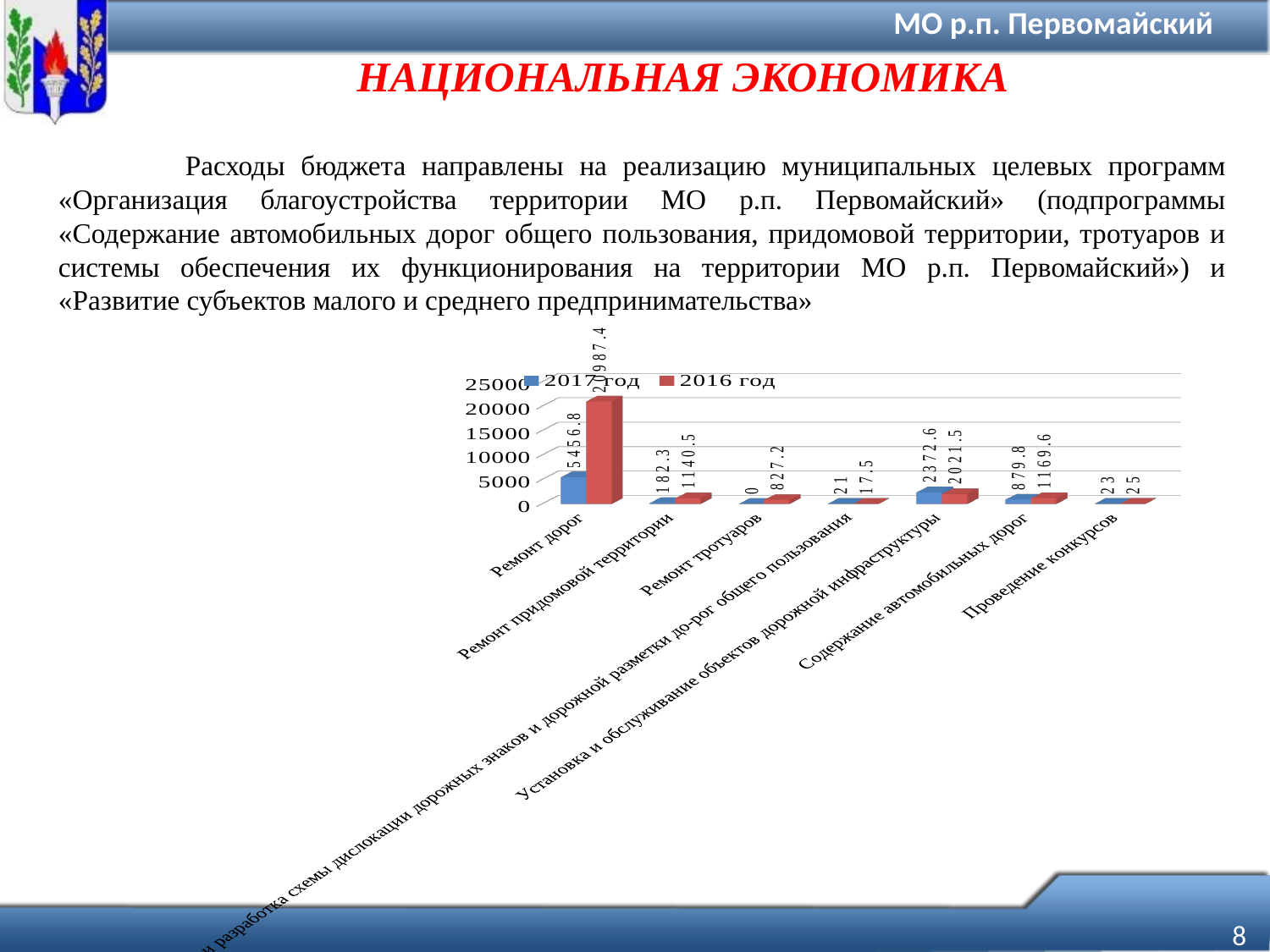
Which category has the lowest value in the 2017 год series? Ремонт тротуаров What is the value for Ремонт дорог in the 2017 год series? 5456.8 Which category has the highest value in the 2016 год series? Ремонт дорог What is the value for Ремонт дорог in the 2016 год series? 20987.4 What is the value for Содержание автомобильных дорог in the 2016 год series? 1169.6 How many categories are shown on the x axis of the chart? 7 How many series does the chart legend list? 2 What is the value for Проведение конкурсов in the 2016 год series? 25 What is the value for Ремонт тротуаров in the 2017 год series? 0 What is the difference between the 2016 год and 2017 год values for Ремонт дорог? 15530.6 Which is larger for Установка и обслуживание объектов дорожной инфраструктуры: the 2017 год value or the 2016 год value? 2017 год Is the 2016 год value for Ремонт дорог greater or less than 20000? greater